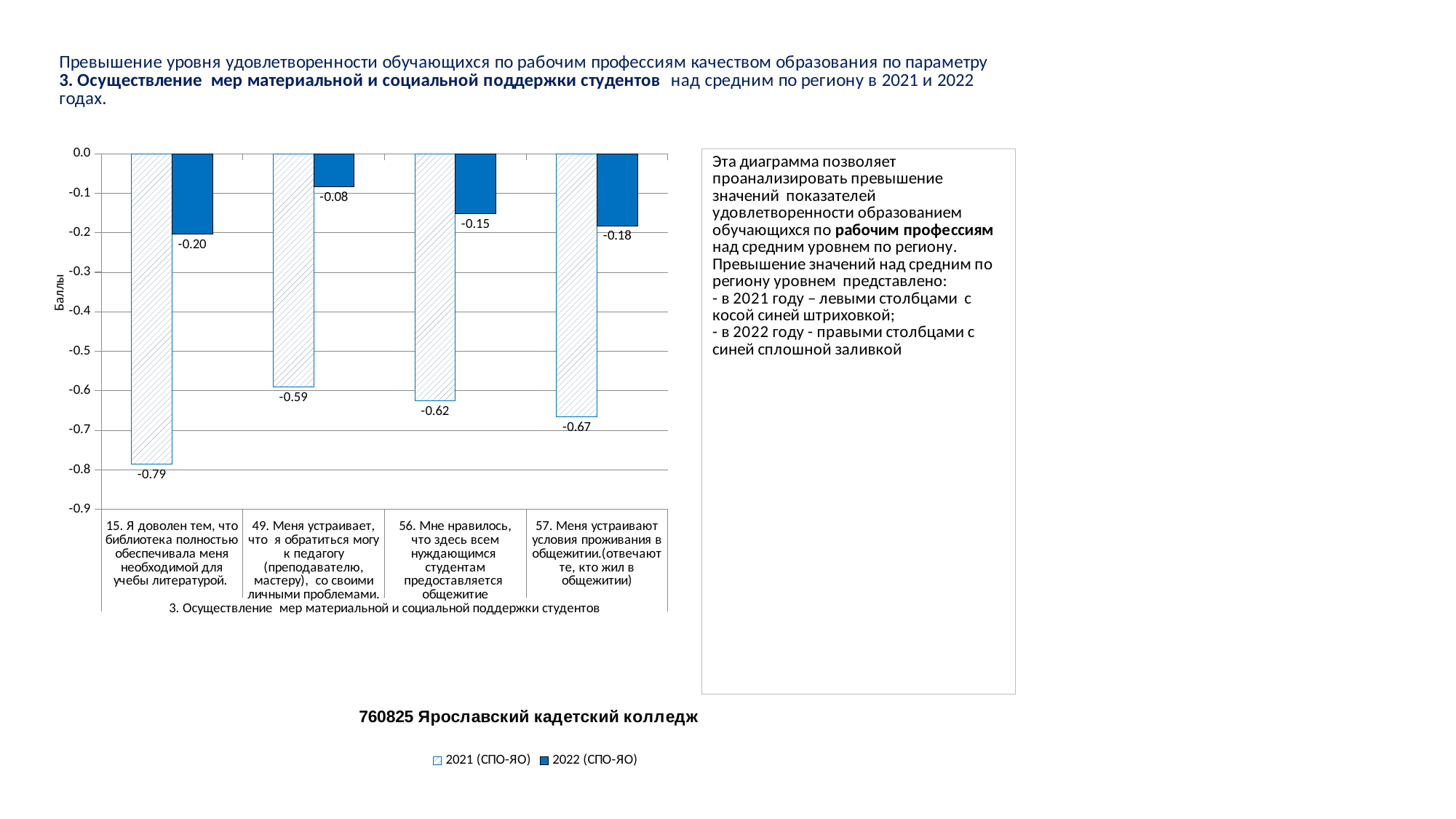
What is the label of the y axis? Баллы How many series does the legend list? 2 What is the difference between the 2021 and 2022 values for category 15? 0.59 How many categories are shown on the x axis? 4 What is the 2021 (СПО-ЯО) value for category 57 ("Меня устраивают условия проживания в общежитии")? -0.67 What is the 2022 (СПО-ЯО) value for category 56 ("Мне нравилось, что здесь всем нуждающимся студентам предоставляется общежитие")? -0.15 Which category has the lowest 2021 (СПО-ЯО) value? 15. Я доволен тем, что библиотека полностью обеспечивала меня необходимой для учебы литературой. Which is larger for category 57: the 2021 (СПО-ЯО) value or the 2022 (СПО-ЯО) value? 2022 (СПО-ЯО) What is the 2022 (СПО-ЯО) value for category 49 ("Меня устраивает, что я обратиться могу к педагогу...")? -0.08 What type of chart is shown on the slide? Bar chart What is the 2021 (СПО-ЯО) value for category 15 ("Я доволен тем, что библиотека полностью обеспечивала меня необходимой для учебы литературой")? -0.79 Which category has the highest 2022 (СПО-ЯО) value? 49. Меня устраивает, что я обратиться могу к педагогу (преподавателю, мастеру), со своими личными проблемами.